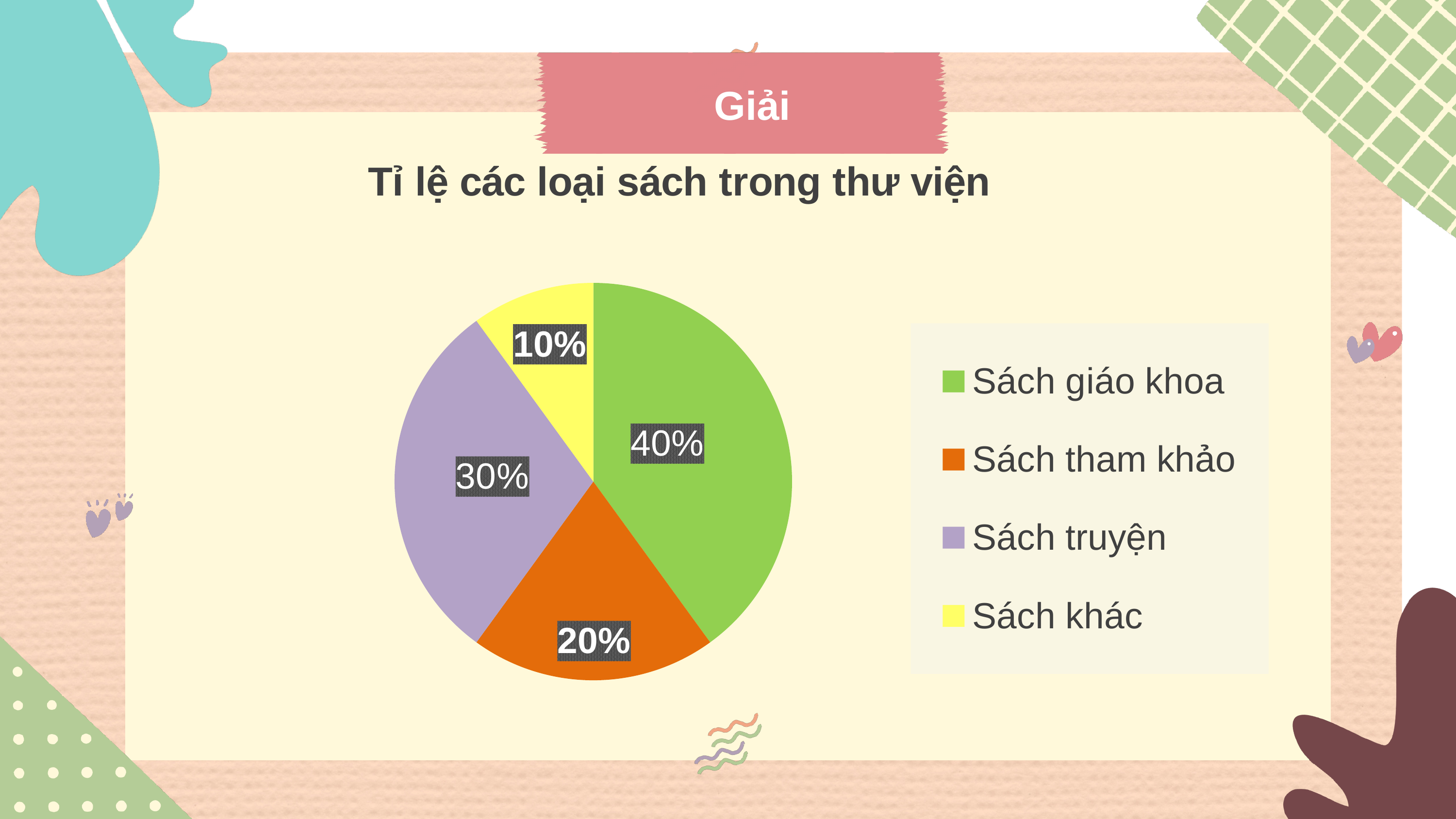
What kind of chart is shown on the slide? pie chart Which category has the smallest share of the pie? Sách khác What colour is the slice for Sách truyện? purple What is the title of the chart? Tỉ lệ các loại sách trong thư viện Which has a larger share, Sách truyện or Sách tham khảo? Sách truyện What is the difference between the shares of Sách giáo khoa and Sách tham khảo? 20% What percentage of the pie is Sách giáo khoa? 40% What percentage of the pie is Sách tham khảo? 20% Which category has the largest share of the pie? Sách giáo khoa What percentage of the pie is Sách truyện? 30% What percentage of the pie is Sách khác? 10% How many categories does the pie chart have? 4